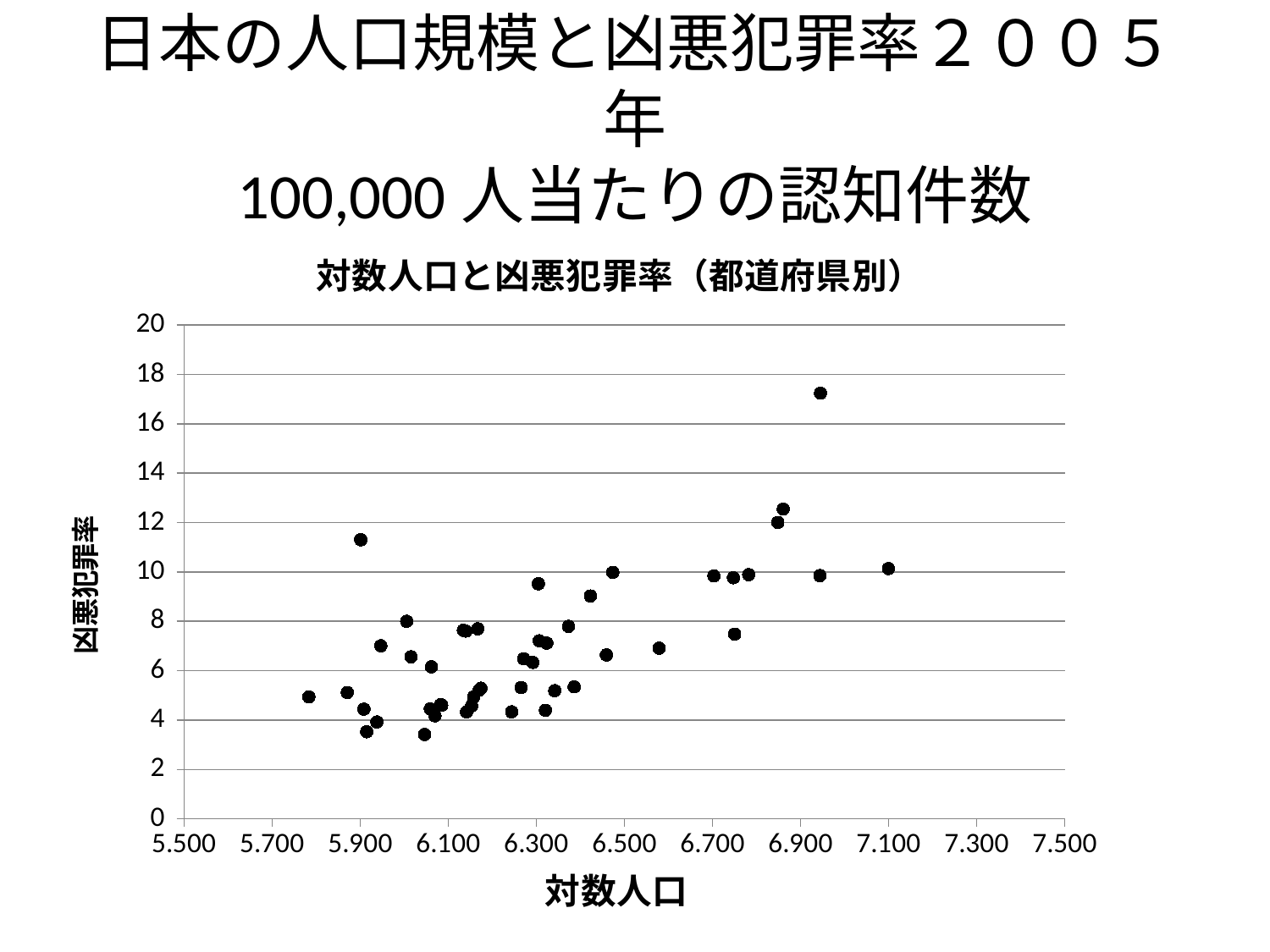
What is the label of the horizontal axis? 対数人口 What kind of chart is shown on the slide? scatter chart What is the maximum value shown on the vertical axis? 20 Overall, do the 凶悪犯罪率 values tend to rise or fall as 対数人口 increases along the x axis? rise Is the 対数人口 value of the highest point greater or less than 7.100? less Is the highest 凶悪犯罪率 value plotted greater or less than 16? greater Is the 凶悪犯罪率 value of the rightmost point greater or less than 8? greater What is the title of the chart? 対数人口と凶悪犯罪率（都道府県別）